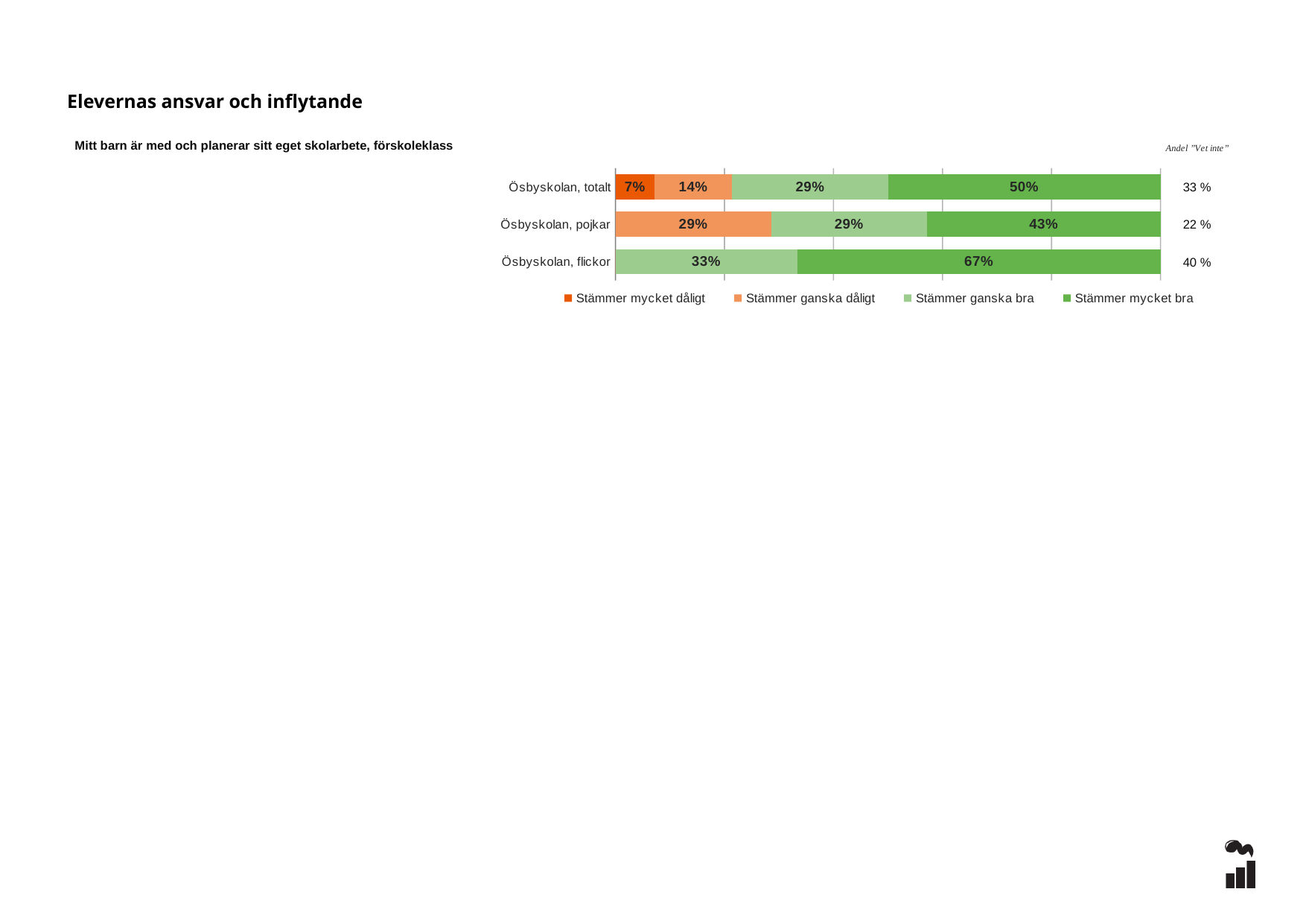
What is the 'Stämmer mycket dåligt' value for Ösbyskolan, totalt? 7% Which category has the highest 'Stämmer mycket bra' value? Ösbyskolan, flickor What is the 'Stämmer ganska bra' value for Ösbyskolan, flickor? 33% What is the 'Stämmer ganska dåligt' value for Ösbyskolan, pojkar? 29% How many series does the legend list? 4 Which category has the lowest 'Stämmer mycket bra' value? Ösbyskolan, pojkar What percentage of 'Stämmer mycket bra' is shown for Ösbyskolan, totalt? 50% What is the difference between the 'Stämmer mycket bra' values for Ösbyskolan, flickor and Ösbyskolan, pojkar? 24% How many categories are shown on the chart? 3 Which is larger: the 'Stämmer ganska dåligt' value for Ösbyskolan, pojkar or for Ösbyskolan, totalt? Ösbyskolan, pojkar What kind of chart is shown on the slide? Stacked bar chart What is the 'Andel "Vet inte"' value shown for Ösbyskolan, flickor? 40 %